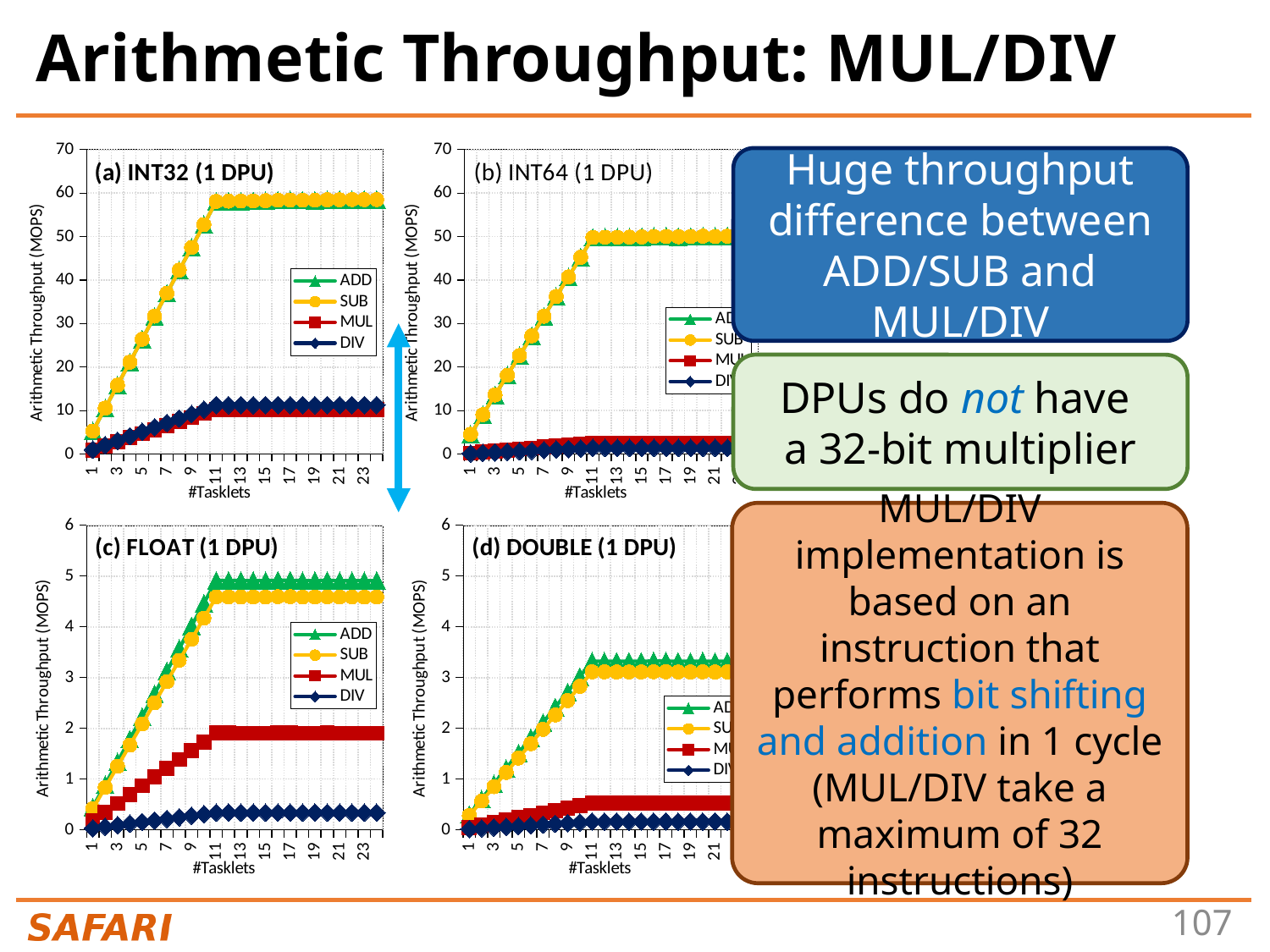
In chart (a) INT32 (1 DPU), which series has the higher throughput at 23 tasklets, ADD or MUL? ADD In chart (a) INT32 (1 DPU), does the ADD throughput rise or fall as the number of tasklets increases from 1 to 11? rise In chart (c) FLOAT (1 DPU), is the DIV throughput at 23 tasklets greater or less than 1 MOPS? less In chart (c) FLOAT (1 DPU), which series has the higher throughput at 23 tasklets, MUL or DIV? MUL What is the label of the y axis in chart (b) INT64 (1 DPU)? Arithmetic Throughput (MOPS) In chart (c) FLOAT (1 DPU), is the MUL throughput at 23 tasklets greater or less than 1 MOPS? greater How many series does the legend of chart (c) FLOAT (1 DPU) list? 4 What kind of chart is chart (a) INT32 (1 DPU)? line chart In chart (c) FLOAT (1 DPU), which series has the lowest throughput across the tasklet range? DIV In chart (a) INT32 (1 DPU), is the ADD throughput at 23 tasklets greater or less than 50 MOPS? greater